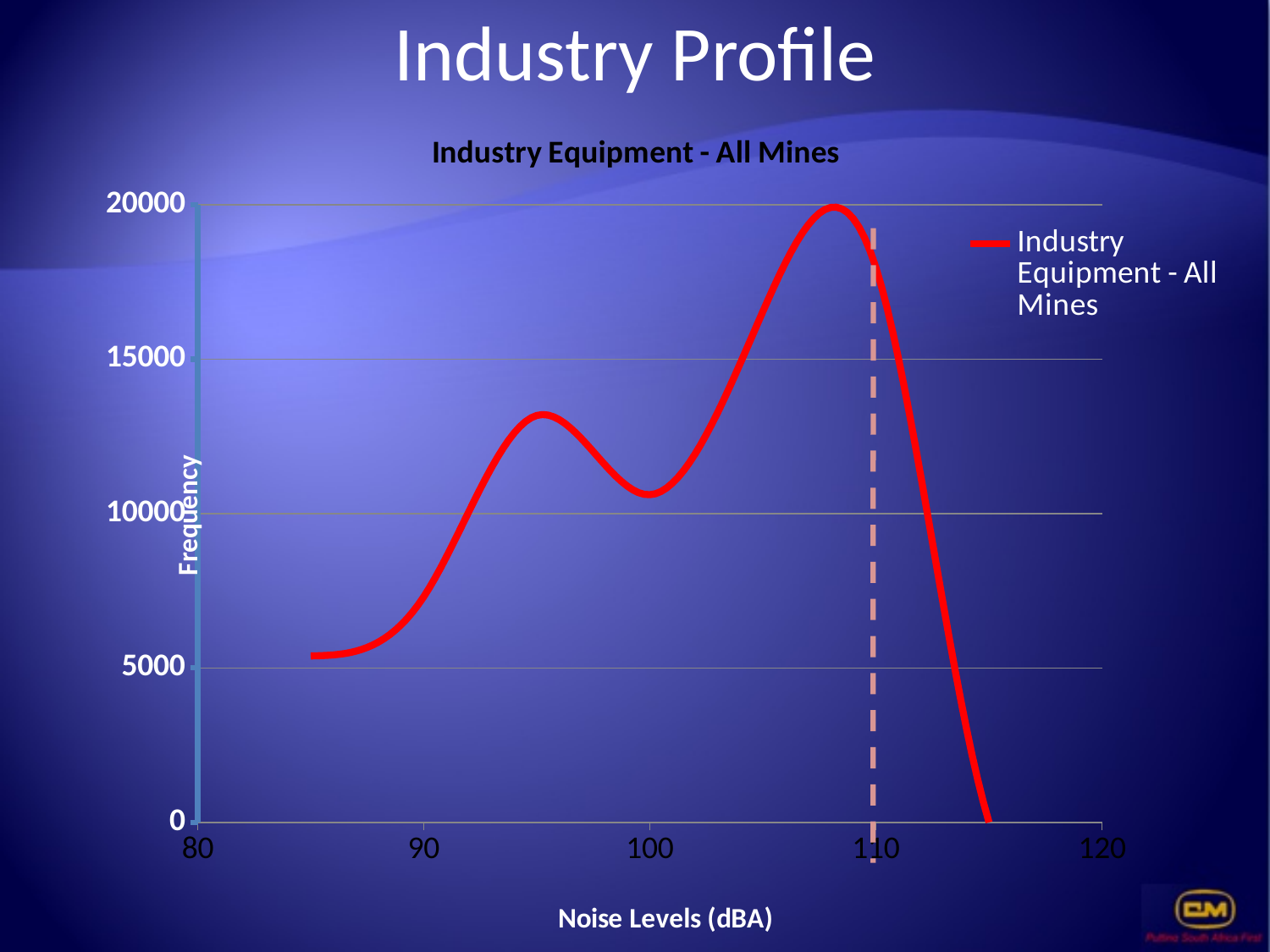
Does the frequency rise or fall as noise level increases from 100 dBA to 108 dBA? rise What is the title of the chart? Industry Equipment - All Mines Is the frequency higher at 110 dBA or at 90 dBA? 110 dBA What kind of chart is shown on the slide? line chart How many series does the legend list? 1 Does the frequency rise or fall as noise level increases from 110 dBA to 115 dBA? fall Is the frequency at 90 dBA greater or less than 5000? greater Is the frequency at 95 dBA greater or less than 10000? greater Is the frequency at 110 dBA greater or less than 15000? greater What is the label of the x axis? Noise Levels (dBA)